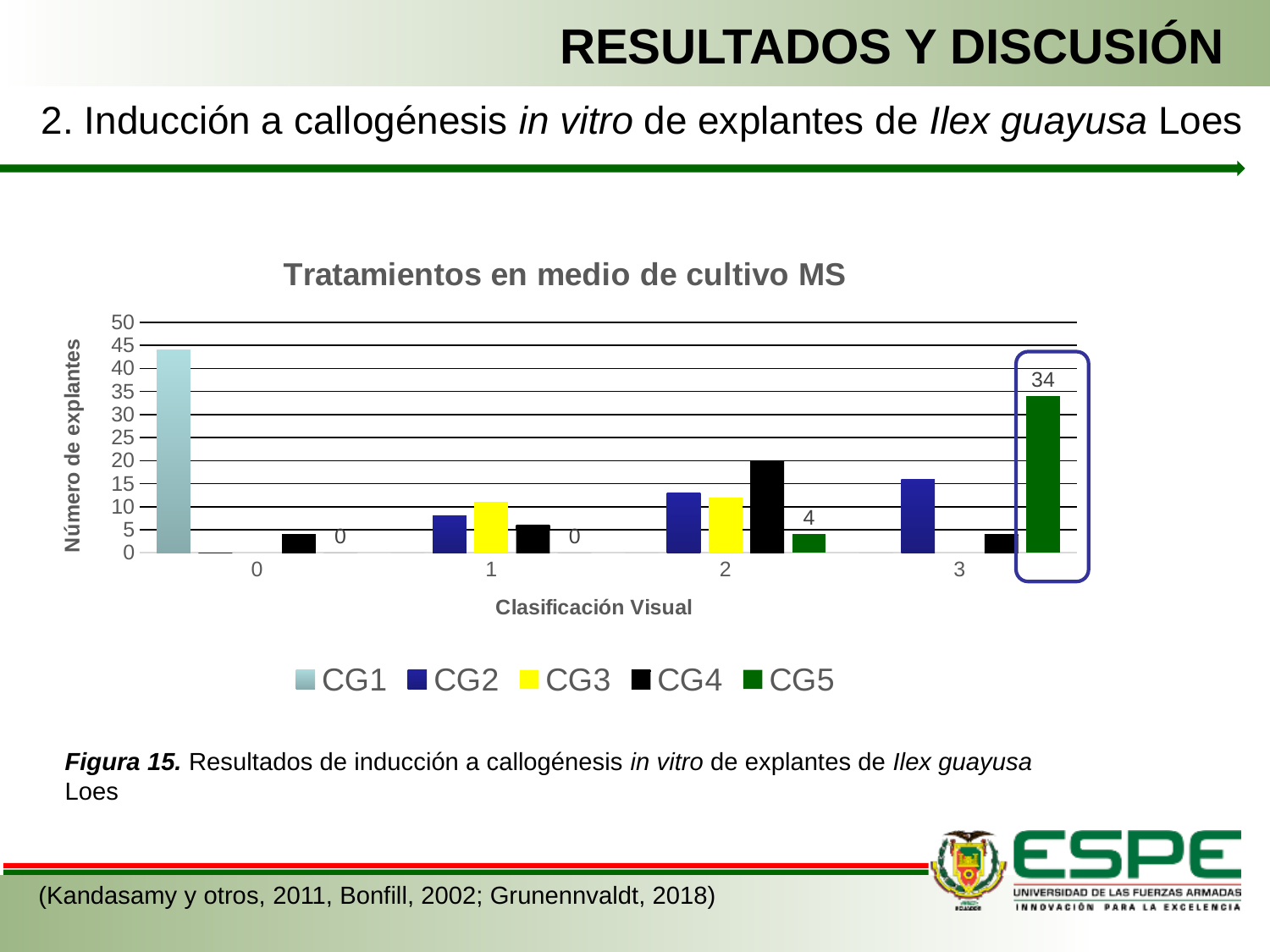
Which is larger: the CG1 bar at Clasificación Visual 0 or the CG5 bar at Clasificación Visual 3? CG1 at Clasificación Visual 0 Is the value for CG4 at Clasificación Visual 2 greater or less than 15? greater What kind of chart is shown on the slide? bar chart Which is larger at Clasificación Visual 3: CG2 or CG4? CG2 How many series does the legend list? 5 Is the value for CG1 at Clasificación Visual 0 greater or less than 40? greater What is the value for CG5 at Clasificación Visual 3? 34 What is the value for CG5 at Clasificación Visual 2? 4 At which Clasificación Visual category is the CG5 value highest? 3 What is the difference between the CG5 values at Clasificación Visual 3 and Clasificación Visual 2? 30 What is the value for CG5 at Clasificación Visual 0? 0 How many Clasificación Visual categories are shown on the x axis? 4